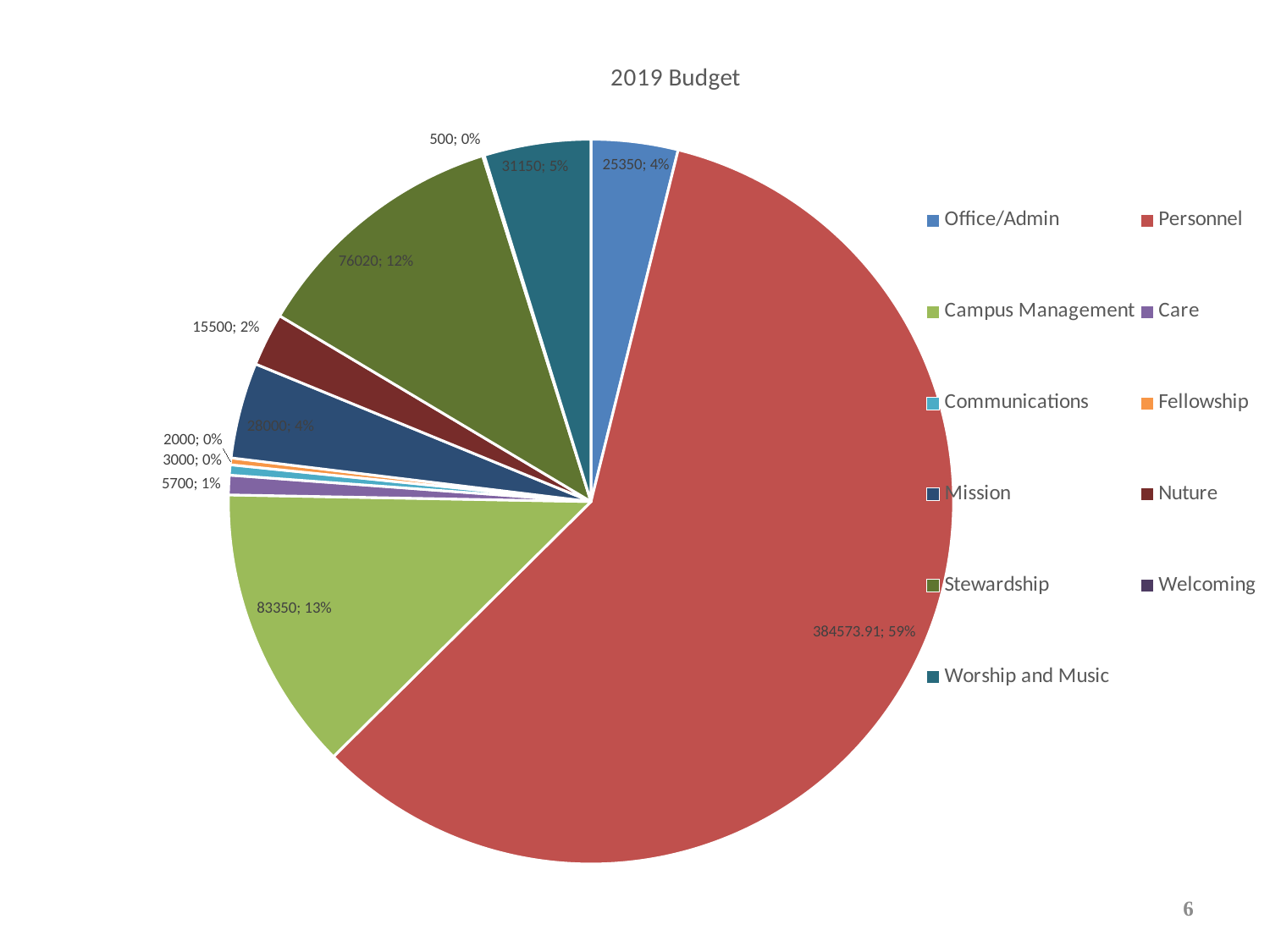
What type of chart is shown on the slide? Pie chart What is the value shown for Worship and Music? 31150 What percentage of the 2019 Budget pie does Personnel represent? 59% What is the value shown for the Personnel slice? 384573.91 What percentage share does Stewardship have in the pie? 12% What is the difference between the Stewardship value and the Nuture value? 60520 What is the title of the chart? 2019 Budget What is the value shown for the Campus Management slice? 83350 How many categories does the legend list? 11 Which category has the largest slice of the pie? Personnel Which category has the smallest slice of the pie? Welcoming Which is larger, the Campus Management slice or the Stewardship slice? Campus Management